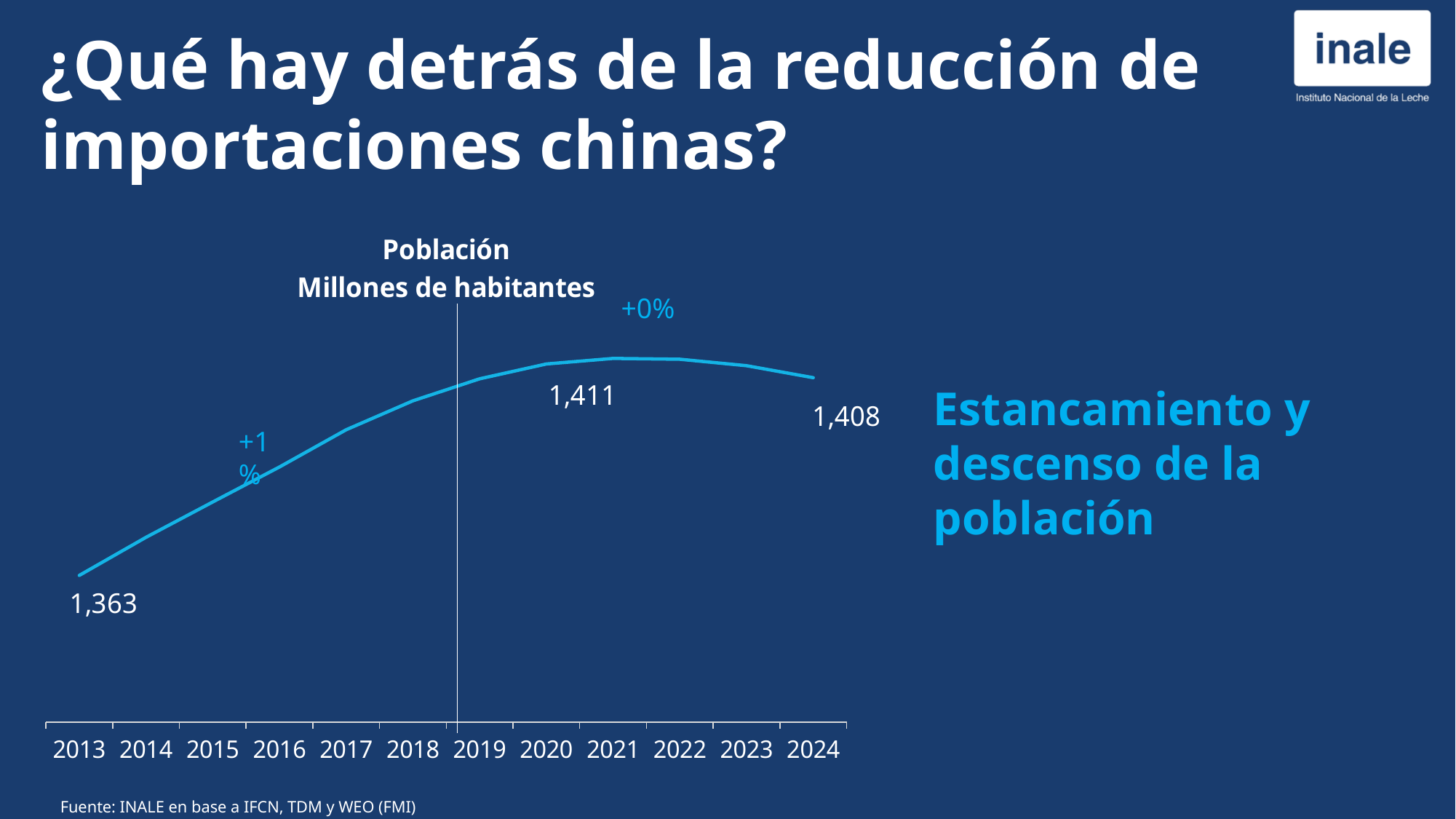
Which year has the lowest population on the chart? 2013 How does the population change from 2013 to 2019 along the x axis? It rises What is the population value labelled near 2020 on the chart? 1,411 Which is larger, the population in 2013 or in 2024? 2024 What is the difference between the 2024 value (1,408) and the 2013 value (1,363)? 45 What kind of chart is used to show the population? Line chart How many years are shown on the x axis of the chart? 12 What is the population value shown for 2013? 1,363 What unit is given in the chart title for the population? Millones de habitantes What is the population value shown for 2024? 1,408 What is the difference between the labelled values 1,411 and 1,408? 3 Which is larger, the labelled value 1,411 or the 2024 value 1,408? 1,411